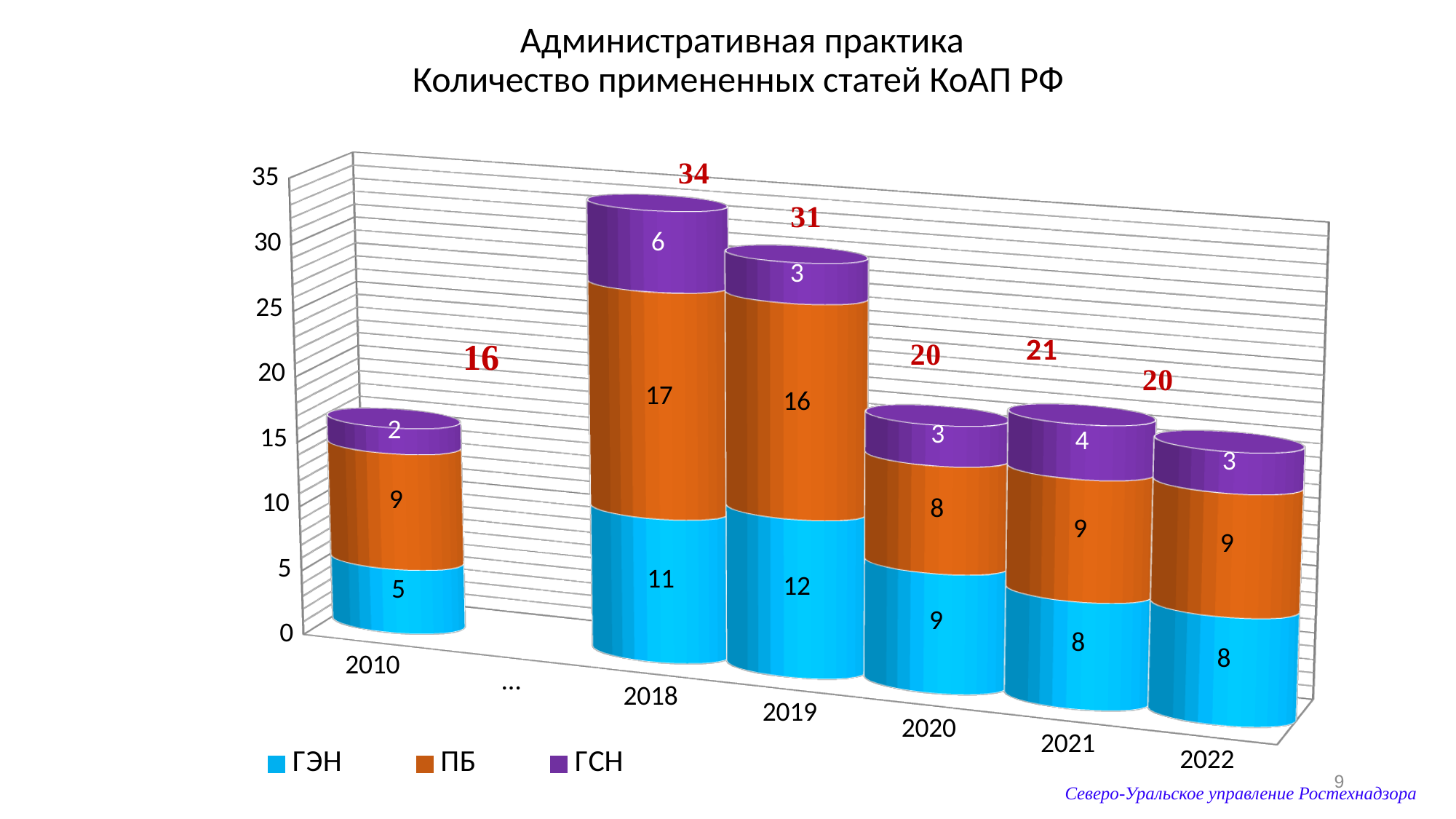
Which year has the lowest total? 2010 What is the total of the stacked bar for 2018? 34 Which series is shown in purple in the legend? ГСН What is the value for ПБ in 2018? 17 How many series does the legend list? 3 What is the value for ГЭН in 2019? 12 What is the difference between the ПБ values for 2018 and 2019? 1 What is the value for ГСН in 2021? 4 What is the total of the stacked bar for 2010? 16 What type of chart is shown on the slide? stacked bar chart Which is larger, the ГЭН value for 2018 or the ГЭН value for 2022? 2018 Which year has the highest total? 2018